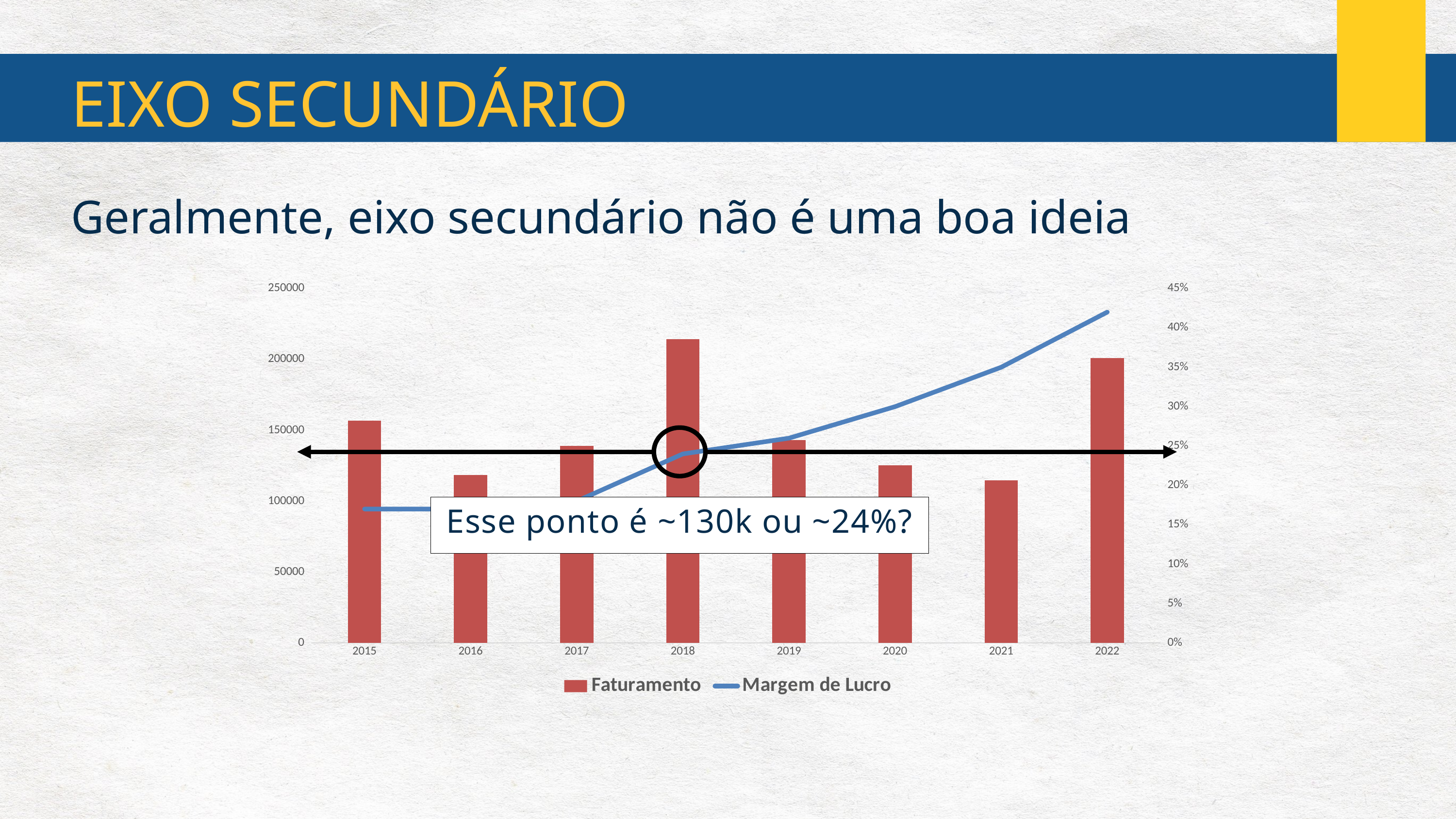
Which year has the highest Faturamento bar? 2018 Is the Faturamento value for 2018 greater or less than 200000? greater Is the Margem de Lucro value for 2015 greater or less than 20%? less Which is larger, the Faturamento bar for 2018 or for 2019? 2018 Does the Margem de Lucro line rise or fall from 2015 to 2022? rise How many categories (years) are shown on the x axis of the chart? 8 Which series is plotted as a line in the chart? Margem de Lucro How many series does the chart legend list? 2 What kind of chart is shown on the slide? Combined bar and line chart Is the Faturamento value for 2021 greater or less than 150000? less Which series is plotted as bars in the chart? Faturamento